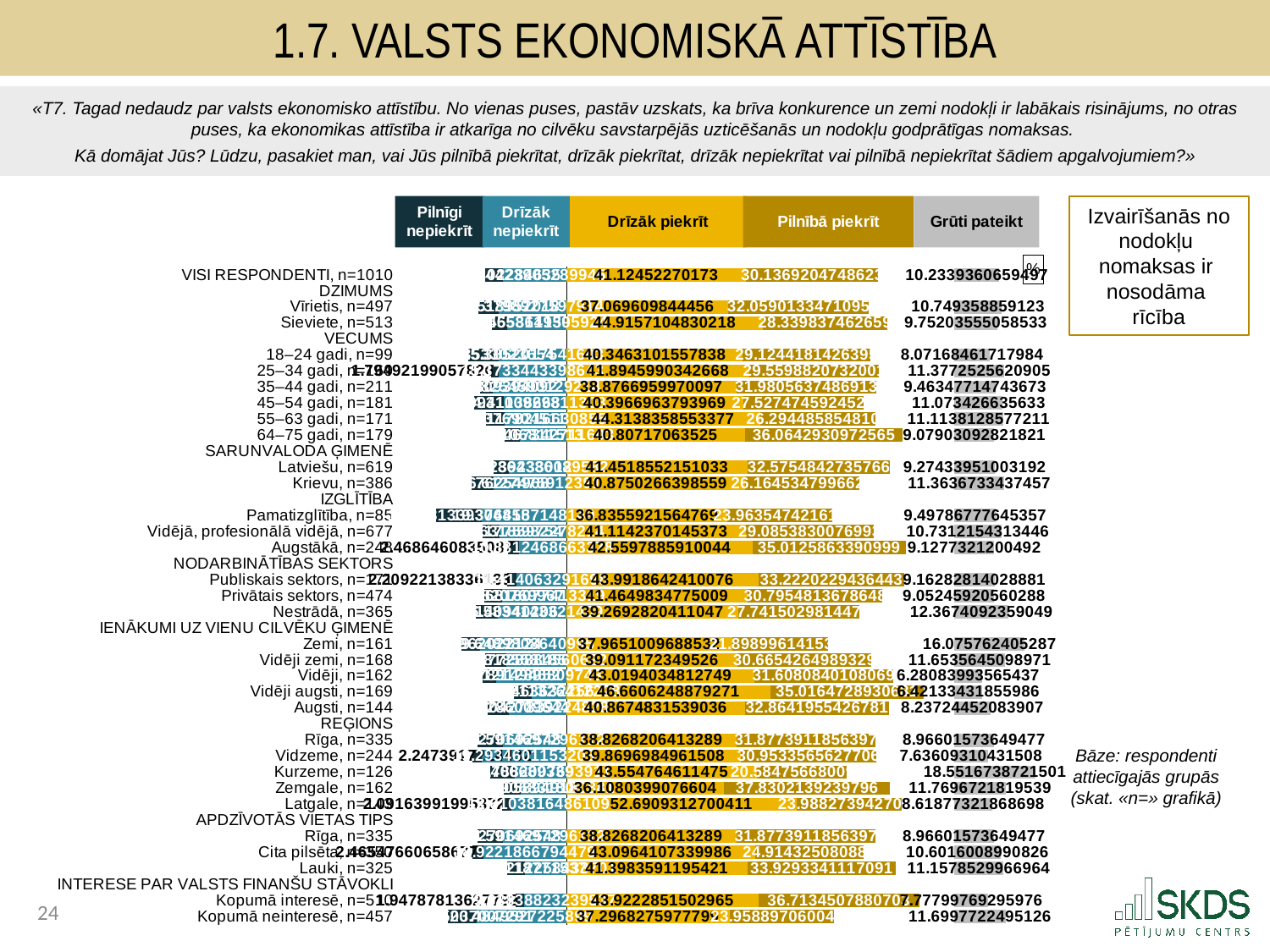
What is the 'Grūti pateikt' value for Zemi, n=161? 16.075762405287 Which has the larger 'Drīzāk piekrīt' value, Vīrietis or Sieviete? Sieviete Among the REĢIONS groups, which has the highest 'Drīzāk piekrīt' value? Latgale What kind of chart is shown on the slide? Stacked horizontal bar chart What is the 'Drīzāk piekrīt' value for Vīrietis, n=497? 37.069609844456 Which legend entry is shown in the grey colour? Grūti pateikt How many series does the legend list? 5 Which has the larger 'Grūti pateikt' value, Kurzeme or Vidzeme? Kurzeme What is the title of the slide containing the chart? 1.7. VALSTS EKONOMISKĀ ATTĪSTĪBA What is the 'Pilnībā piekrīt' value for Vīrietis, n=497? 32.0590133471095 What is the 'Grūti pateikt' value for Kurzeme, n=126? 18.5516738721501